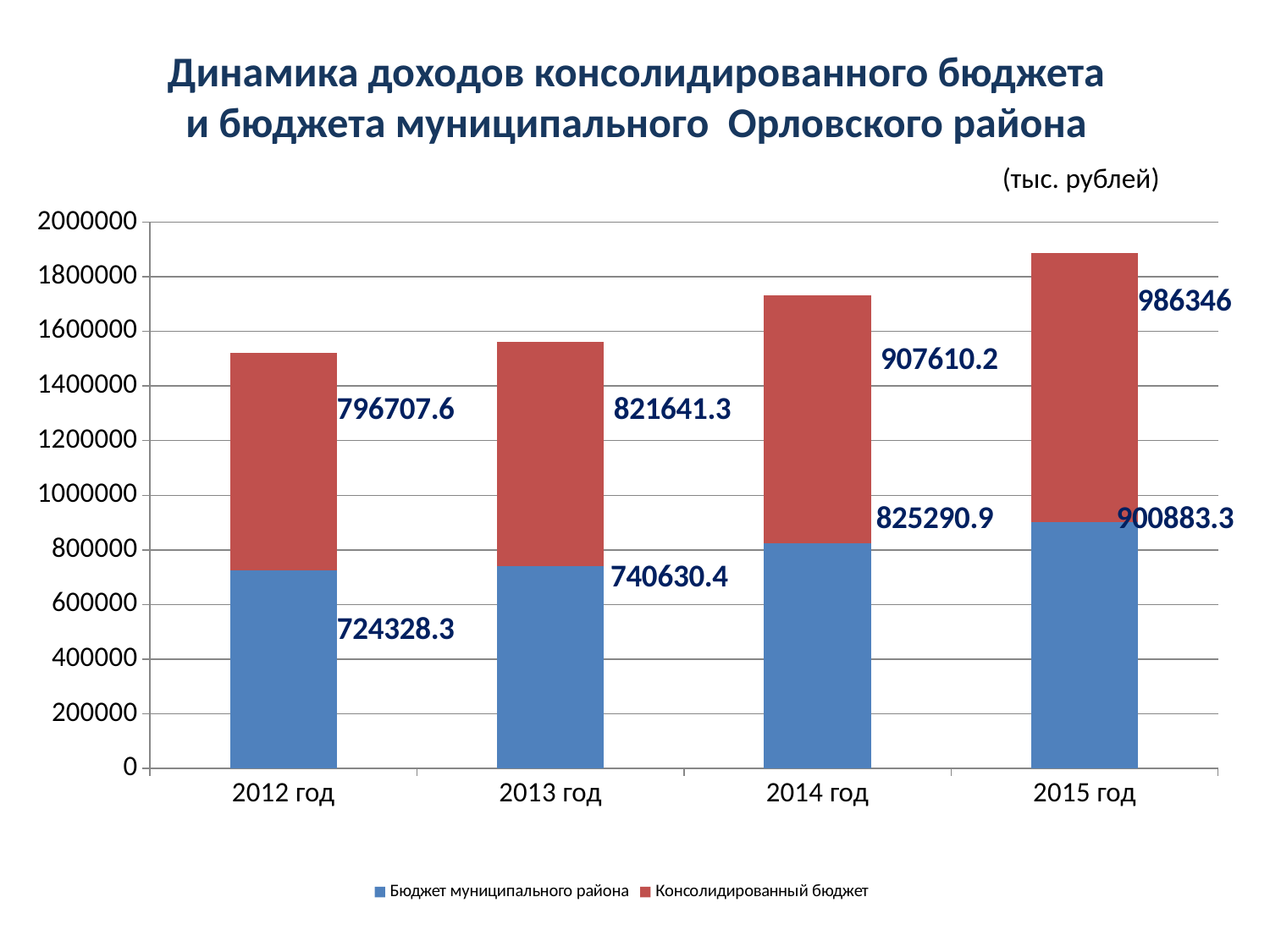
How many years are shown on the x axis? 4 How many series does the legend list? 2 In which year is the Консолидированный бюджет value the lowest? 2012 год What is the difference between the Консолидированный бюджет values for 2015 год and 2012 год? 189638.4 What kind of chart is shown on the slide? Stacked bar chart What is the value of Бюджет муниципального района for 2012 год? 724328.3 What is the total height of the stacked bar for 2012 год? 1521035.9 What is the value of Консолидированный бюджет for 2014 год? 907610.2 Which is larger for 2013 год: Бюджет муниципального района or Консолидированный бюджет? Консолидированный бюджет What is the difference between the Бюджет муниципального района values for 2015 год and 2014 год? 75592.4 What is the value of Консолидированный бюджет for 2015 год? 986346 In which year is the Бюджет муниципального района value the highest? 2015 год